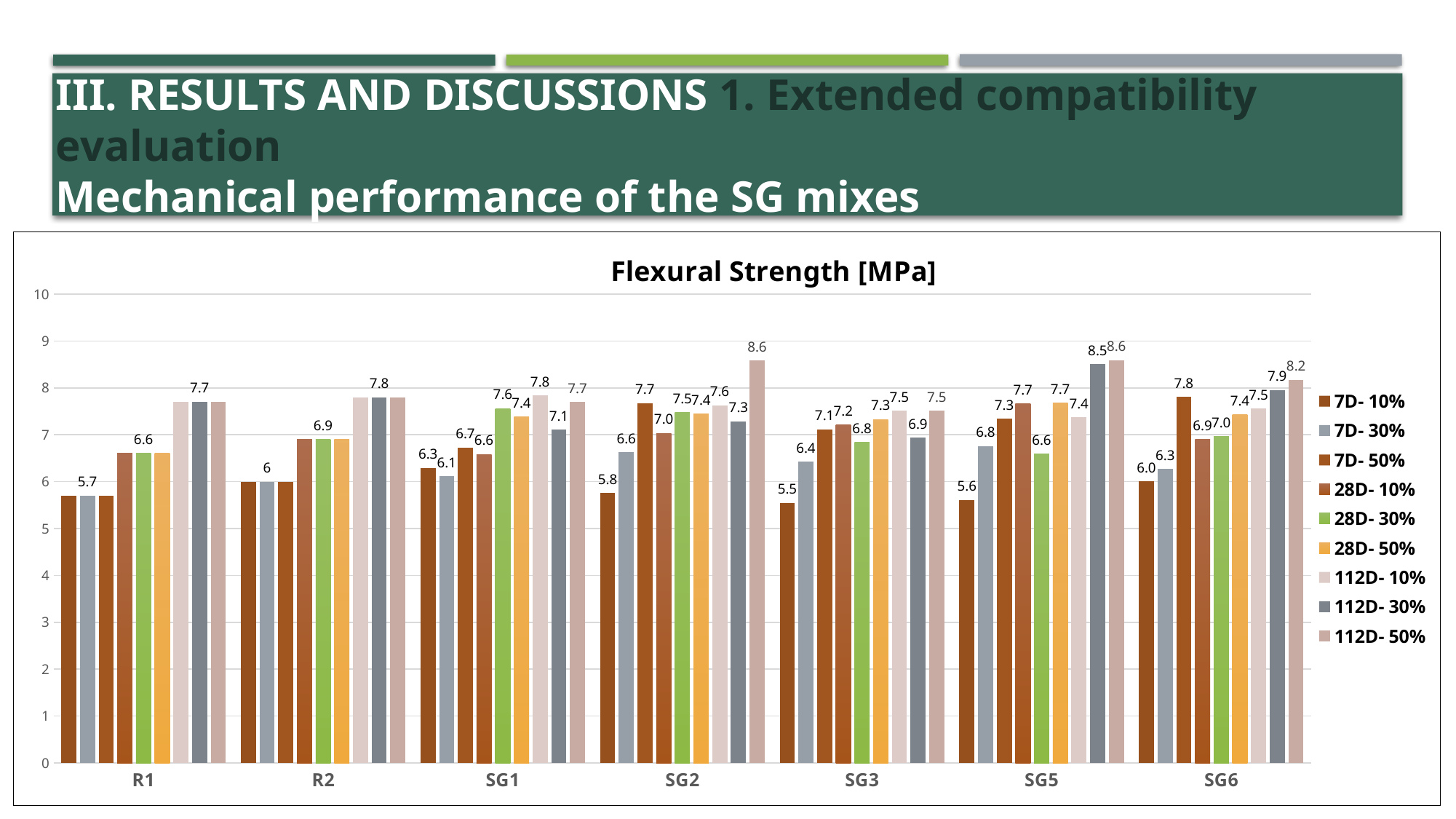
How many mix categories are shown on the x axis? 7 Which mix has the lowest 7D- 10% flexural strength? SG3 What is the flexural strength of SG1 for the 28D- 30% series? 7.6 What is the difference between the 112D- 30% and 7D- 10% flexural strengths for SG5? 2.9 What is the flexural strength of R2 for the 28D- 10% series? 6.9 How many series does the legend list? 9 What kind of chart is shown on the slide? bar chart What is the flexural strength of SG2 for the 112D- 50% series? 8.6 Is the 112D- 30% value for R1 greater or less than 7? greater What is the flexural strength of SG3 for the 7D- 10% series? 5.5 For SG6, which is larger: the 7D- 50% value or the 28D- 10% value? 7D- 50% What is the title of the chart? Flexural Strength [MPa]